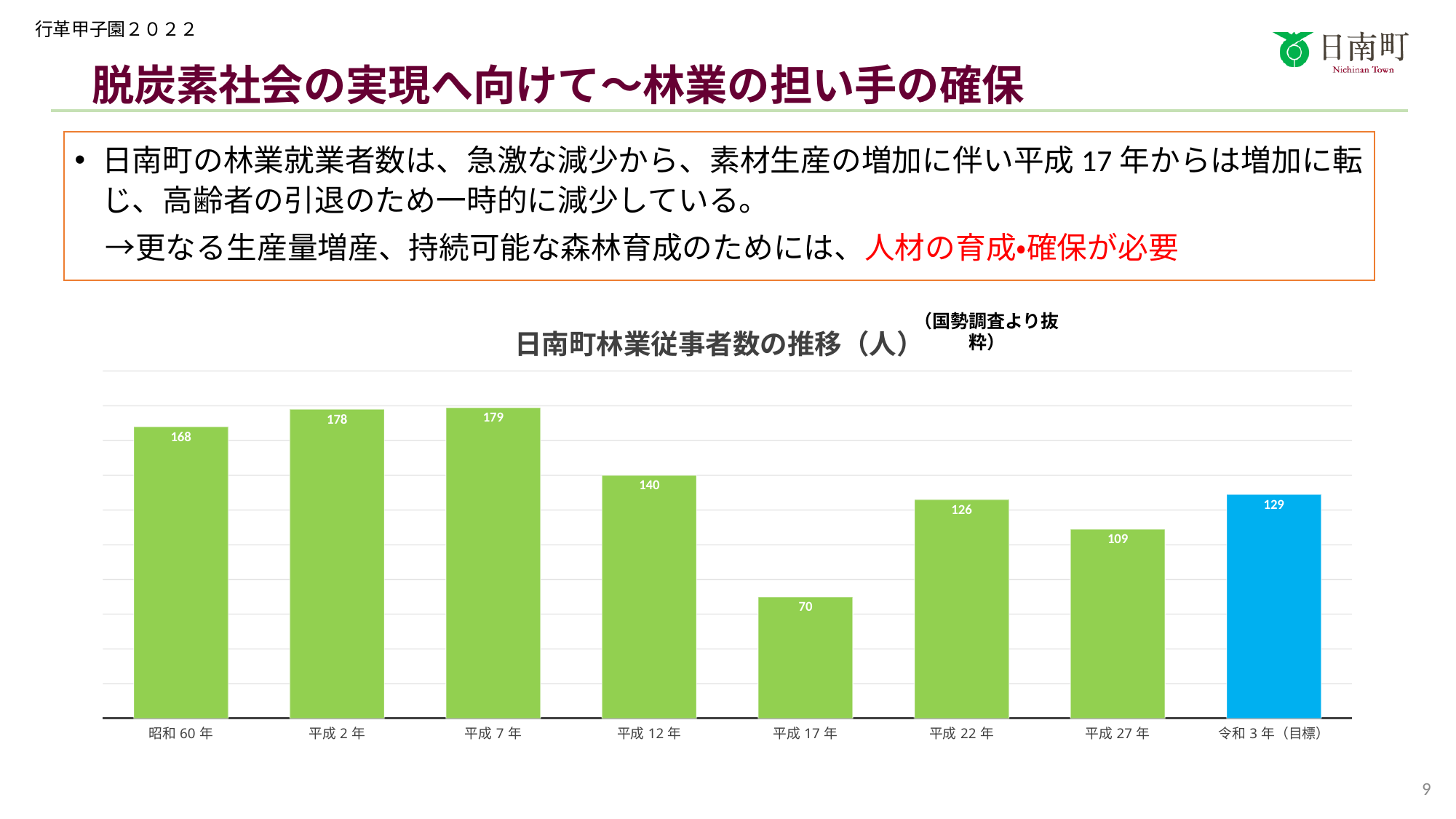
How many categories are shown on the x axis? 8 What is the title of the chart? 日南町林業従事者数の推移（人） Do the values rise or fall from 平成 7 年 to 平成 17 年? fall What kind of chart is this? bar chart Which category has the highest value? 平成 7 年 What is the value for 平成 17 年? 70 What is the difference between the values for 平成 12 年 and 平成 17 年? 70 Which is larger, the value for 平成 22 年 or the value for 令和 3 年（目標）? 令和 3 年（目標） Which category has the lowest value? 平成 17 年 What is the value for 平成 7 年? 179 What is the difference between the values for 昭和 60 年 and 平成 27 年? 59 What is the value for 令和 3 年（目標）? 129